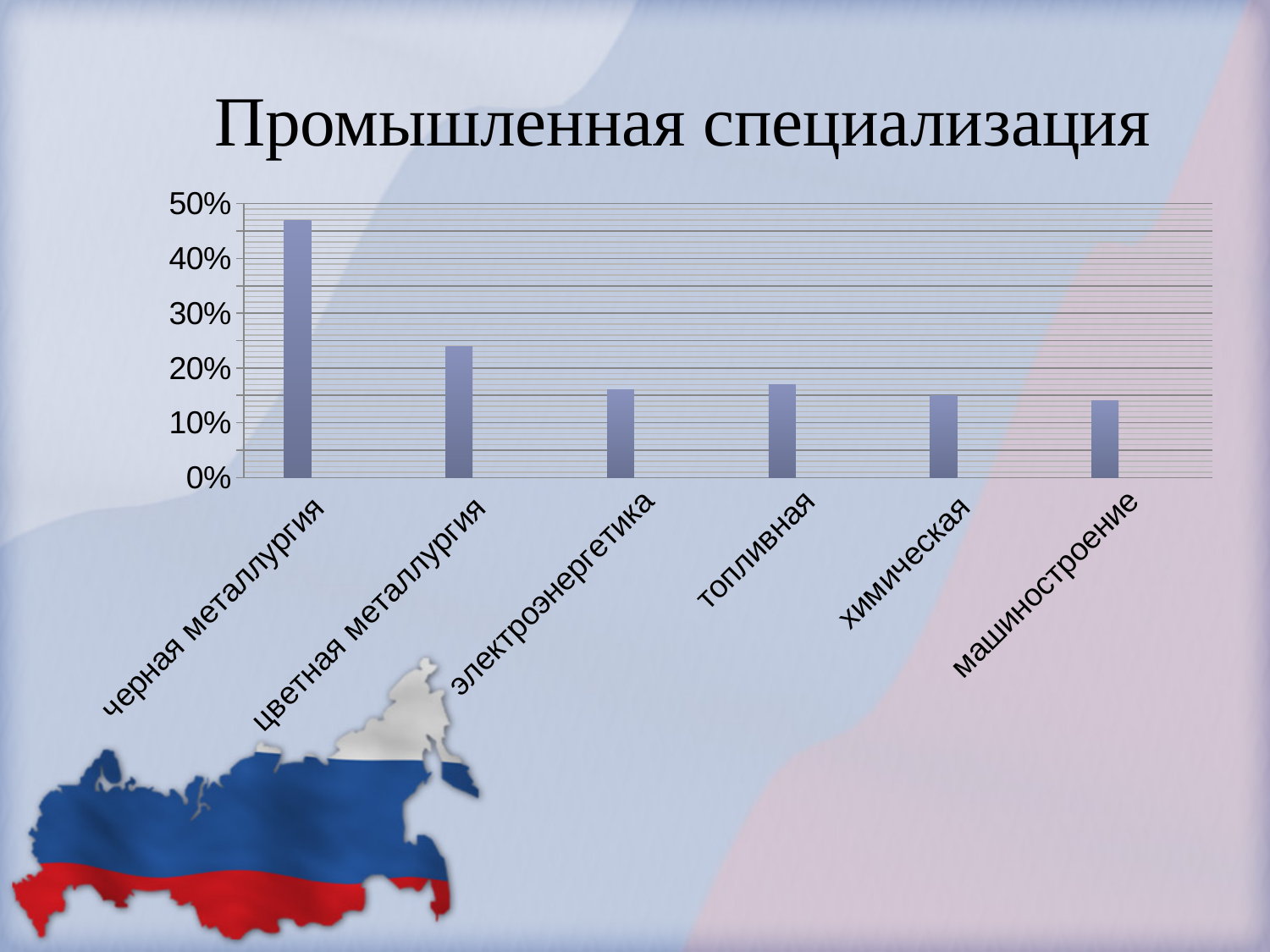
Is the value for химическая greater or less than 20%? less Is the value for цветная металлургия greater or less than 20%? greater Which is larger, the value for черная металлургия or the value for цветная металлургия? черная металлургия Which is larger, the value for цветная металлургия or the value for топливная? цветная металлургия How many categories are plotted on the chart? 6 Is the value for электроэнергетика greater or less than 20%? less Which category has the highest value? черная металлургия What is the title of the slide containing the chart? Промышленная специализация What kind of chart is shown on the slide? bar chart